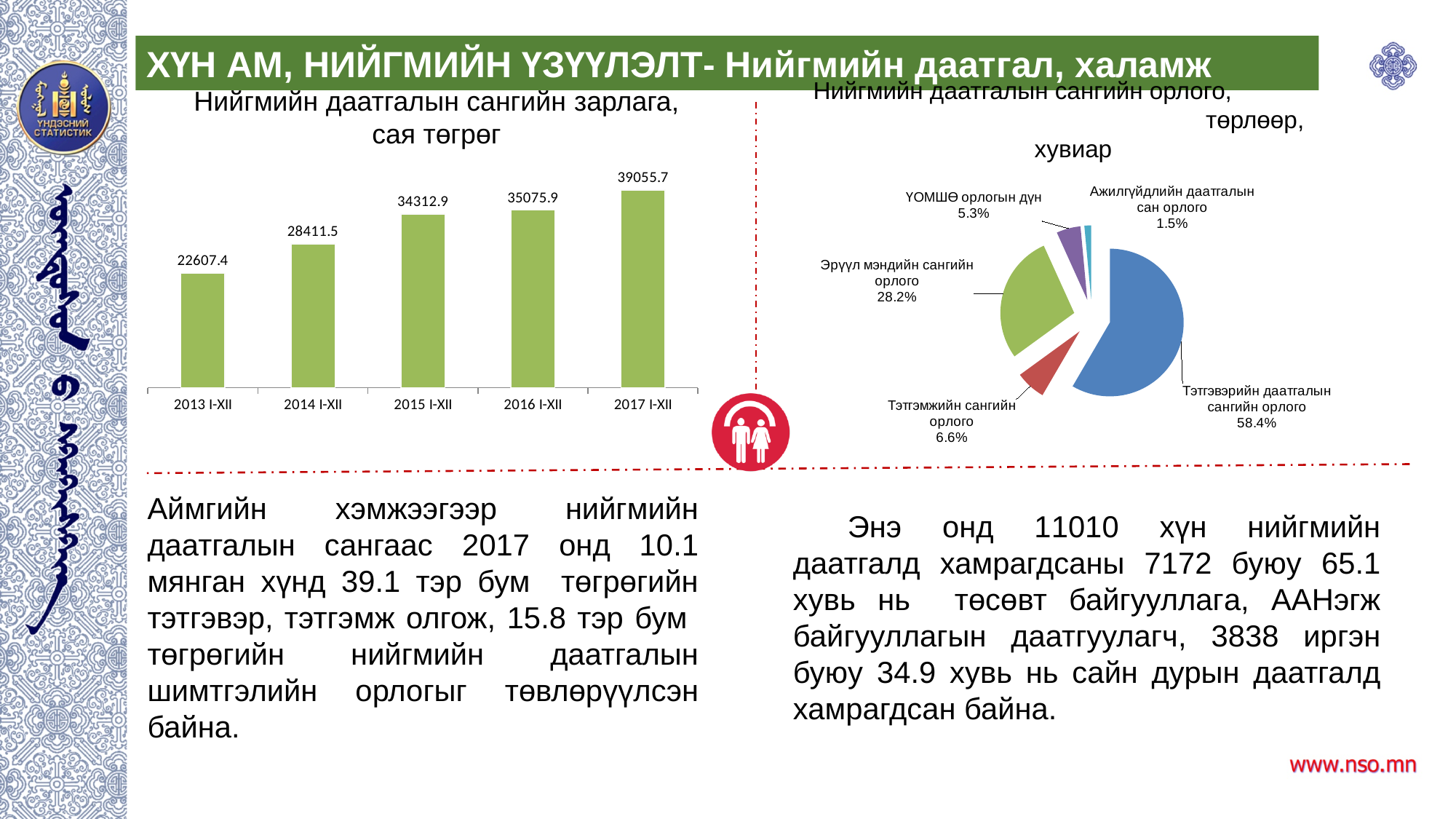
In the bar chart on the left, which year has the lowest value? 2013 I-XII In the bar chart on the left, what is the value for 2017 I-XII? 39055.7 In the pie chart on the right, which slice is the smallest? Ажилгүйдлийн даатгалын сан орлого In the pie chart on the right, what share does Эрүүл мэндийн сангийн орлого have? 28.2% In the pie chart on the right, what share does Тэтгэврийн даатгалын сангийн орлого have? 58.4% In the bar chart on the left, what is the difference between the values for 2017 I-XII and 2016 I-XII? 3979.8 In the bar chart on the left, what is the value for 2013 I-XII? 22607.4 What kind of chart is the chart on the left? bar chart In the pie chart on the right, which is larger: Тэтгэмжийн сангийн орлого or ҮОМШӨ орлогын дүн? Тэтгэмжийн сангийн орлого How many bars are in the bar chart on the left? 5 In the bar chart on the left, which year has the highest value? 2017 I-XII In the bar chart on the left, do the values rise or fall from 2013 I-XII to 2017 I-XII? rise